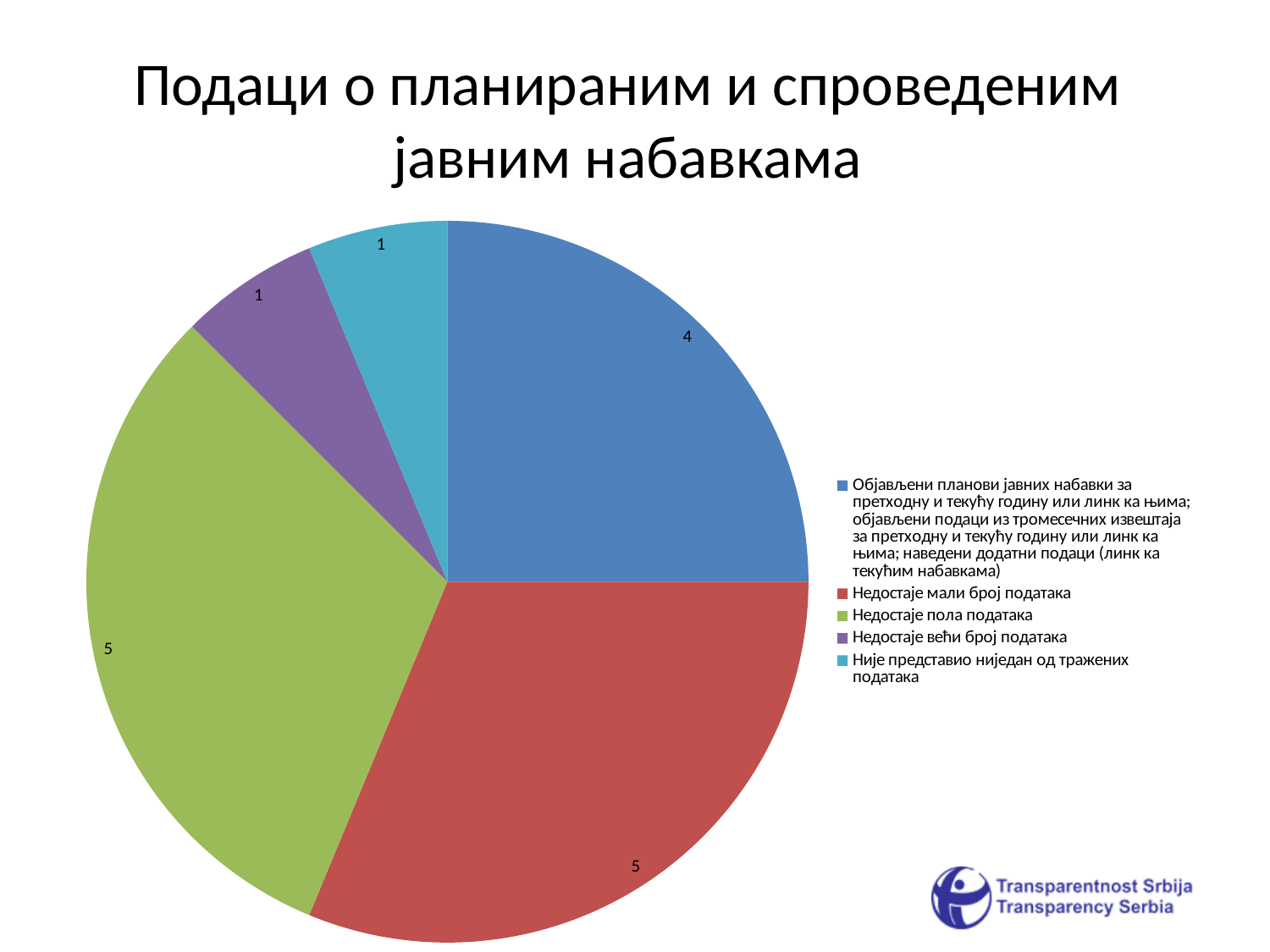
What is the title of the chart slide? Подаци о планираним и спроведеним јавним набавкама What is the value for "Недостаје већи број података"? 1 What type of chart is shown on the slide? pie chart What is the value for "Недостаје мали број података"? 5 Which is larger: the value for "Недостаје мали број података" or the value for the blue slice "Објављени планови јавних набавки..."? Недостаје мали број података How many entries does the legend list? 5 What is the value of the blue slice ("Објављени планови јавних набавки...")? 4 What is the difference between the value for "Недостаје пола података" and the value for "Недостаје већи број података"? 4 What is the value for "Није представио ниједан од тражених података"? 1 What share of the pie does the blue slice "Објављени планови јавних набавки..." (value 4) represent? 25% How many slices does the pie chart have? 5 What is the value for "Недостаје пола података"? 5